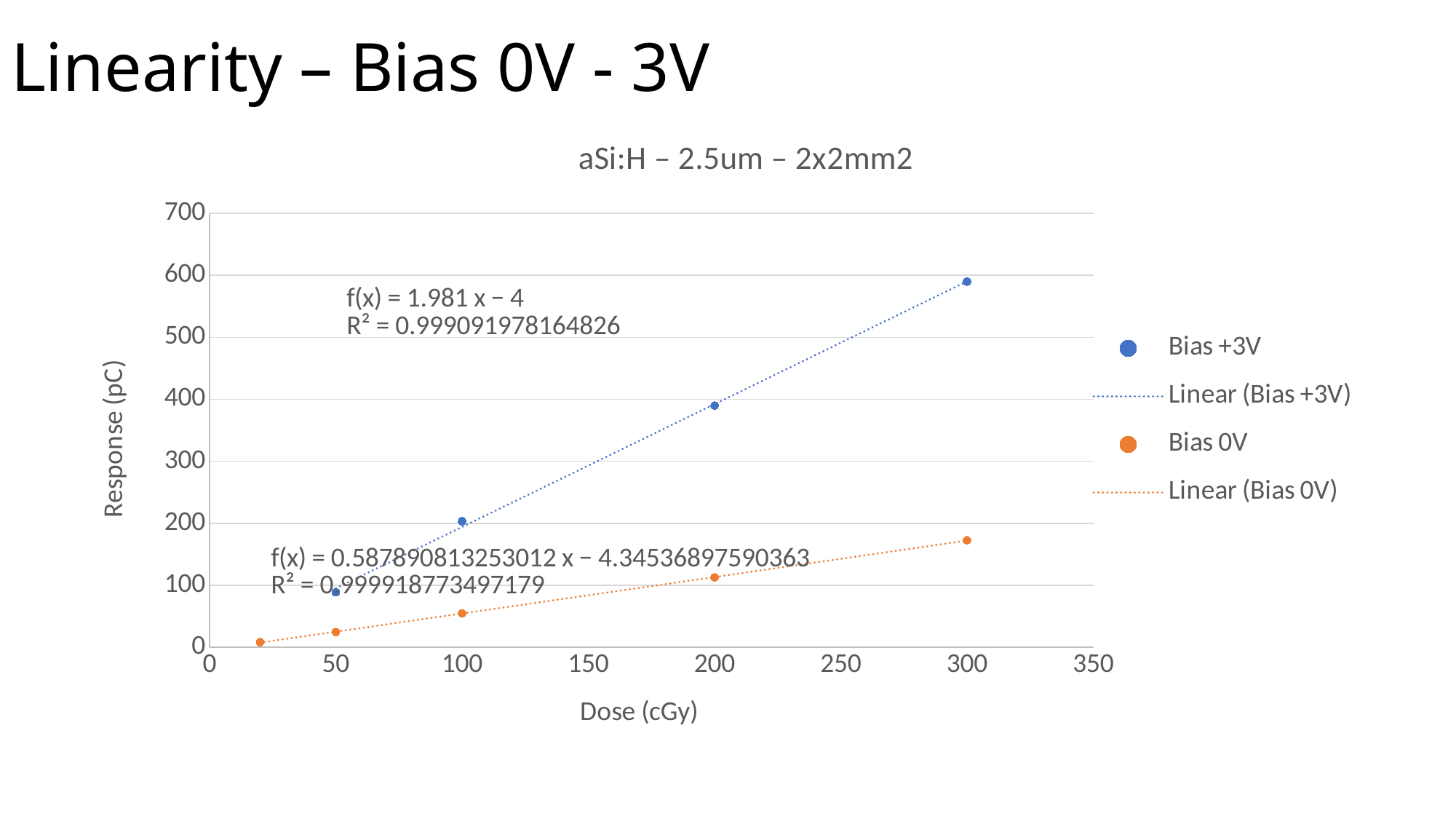
Is the Bias 0V response at 300 cGy greater or less than 200 pC? less Which series reaches the highest response on the chart? Bias +3V How many entries does the chart legend list? 4 Does the response for Bias 0V rise or fall as dose increases? Rises What is the label of the x axis? Dose (cGy) At 200 cGy, which series has the larger response, Bias +3V or Bias 0V? Bias +3V How many data points are plotted for the Bias +3V series? 4 What kind of chart is shown on the slide? Scatter chart What is the title of the chart? aSi:H – 2.5um – 2x2mm2 Is the Bias +3V response at 200 cGy greater or less than 300 pC? greater Is the Bias +3V response at 300 cGy greater or less than 500 pC? greater Does the response for Bias +3V rise or fall as dose increases? Rises